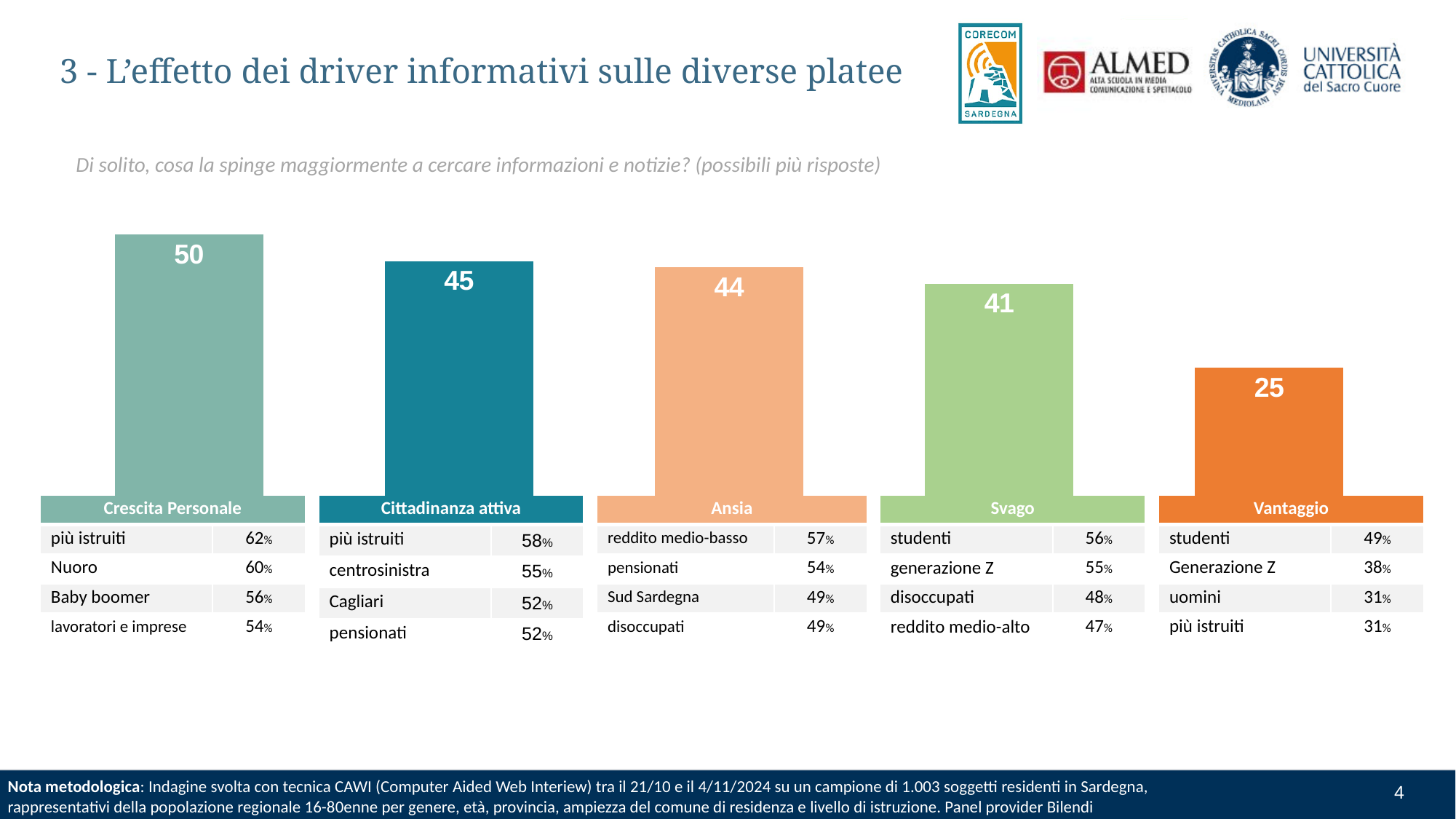
What is the difference between the values for Cittadinanza attiva and Svago? 4 Which category has the highest value? Crescita Personale What is the difference between the values for Crescita Personale and Vantaggio? 25 What is the value shown for Crescita Personale? 50 What colour is the bar for Vantaggio? orange What is the value shown for Vantaggio? 25 What kind of chart is shown on the slide? bar chart Do the values rise or fall from left to right across the categories? fall How many categories are shown in the chart? 5 Which is larger, the value for Cittadinanza attiva or the value for Ansia? Cittadinanza attiva Which category has the lowest value? Vantaggio What is the value shown for Ansia? 44